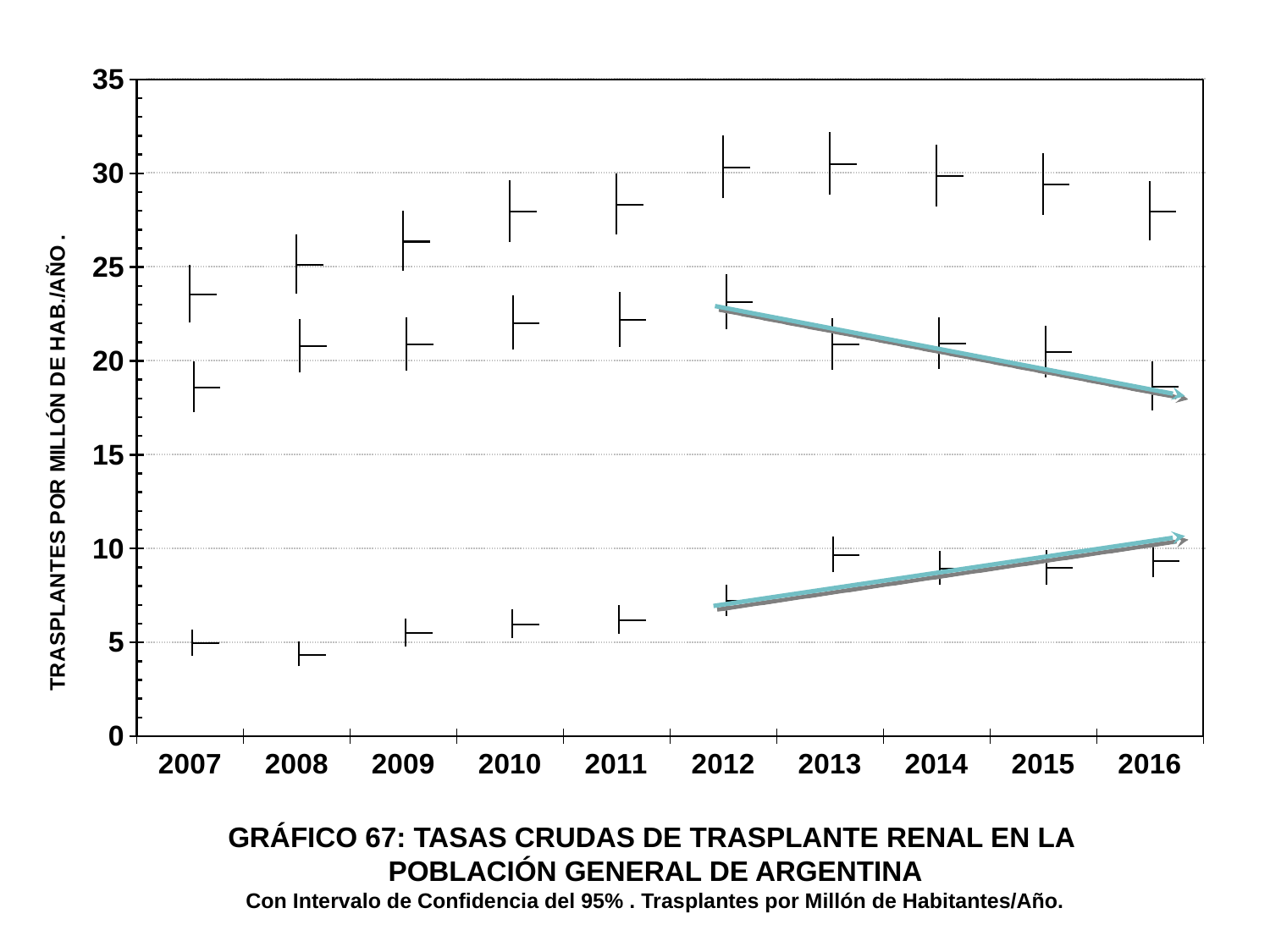
In which year is the top series at its lowest? 2007 How many years are shown on the x axis? 10 Is the value of the middle series in 2012 greater or less than 20? greater Does the bottom series rise or fall from 2007 to 2016? rise Is the value of the bottom series in 2008 greater or less than 5? less Is the value of the top series in 2007 greater or less than 25? less What confidence interval does the chart subtitle say the error bars represent? 95% What is the title of the chart? GRÁFICO 67: TASAS CRUDAS DE TRASPLANTE RENAL EN LA POBLACIÓN GENERAL DE ARGENTINA Does the middle series rise or fall from 2012 to 2016? fall In which year is the bottom series at its lowest? 2008